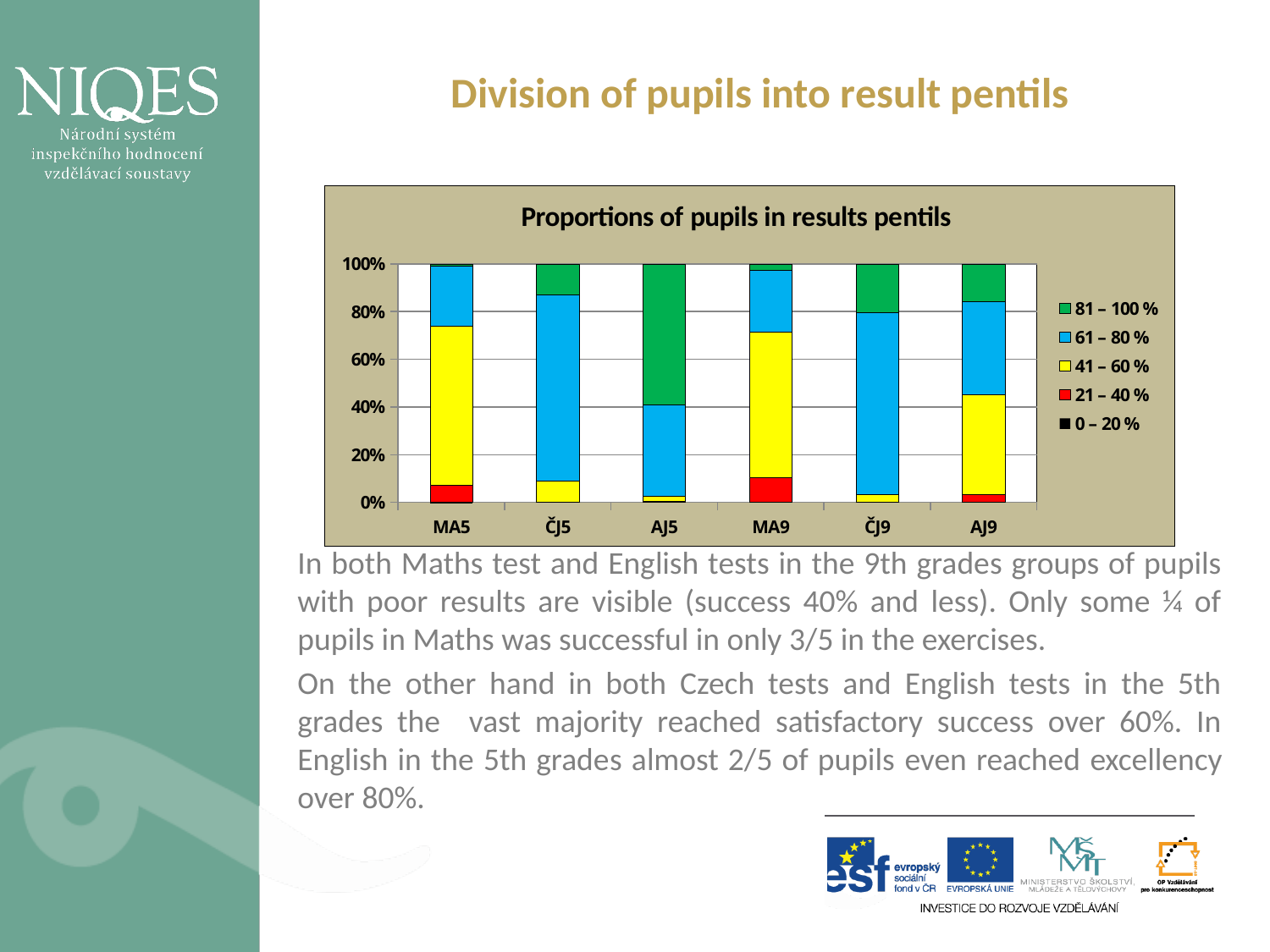
Is the share of pupils in the 21 – 40 % pentil for MA9 greater or less than 20%? less Is the share of pupils in the 81 – 100 % pentil for AJ5 greater or less than 40%? greater How many series does the chart's legend list? 5 Which category has a larger share of pupils in the 41 – 60 % pentil, MA5 or AJ5? MA5 Is the share of pupils in the 61 – 80 % pentil for ČJ5 greater or less than 60%? greater Which category has a larger share of pupils in the 61 – 80 % pentil, ČJ5 or AJ5? ČJ5 What is the title of the chart? Proportions of pupils in results pentils Which category has the largest share of pupils in the 81 – 100 % pentil? AJ5 What kind of chart is shown on the slide? Stacked bar chart How many categories are shown on the x axis of the chart? 6 Which colour represents the 41 – 60 % pentil in the chart? Yellow